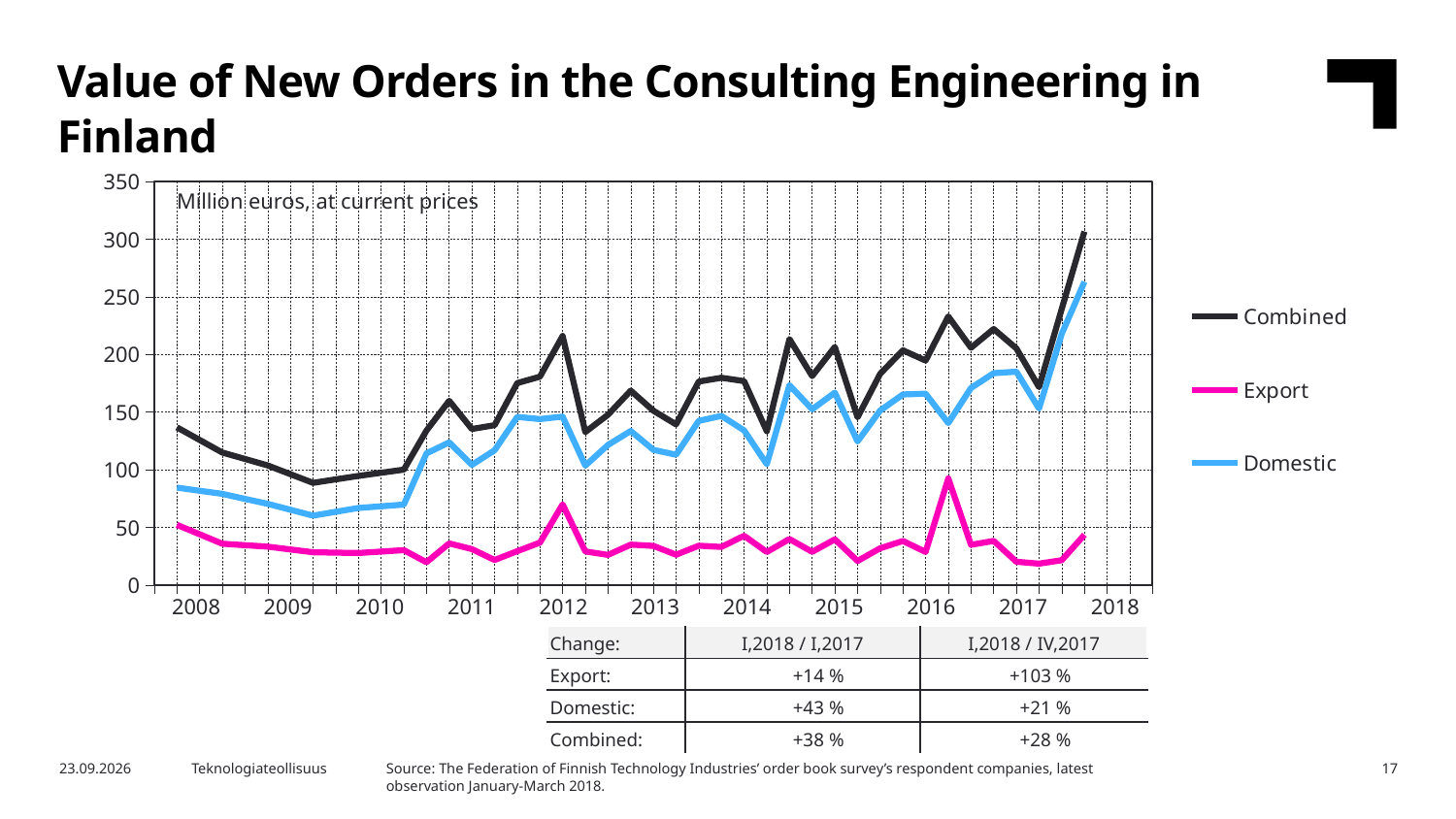
What kind of chart is shown on the slide? Line chart Is the value of the Export series at the final point in 2018 greater or less than 50? less Does the Combined series rise or fall between 2017 and 2018? rise What unit is stated inside the chart area? Million euros, at current prices Is the value of the Combined series at the final point in 2018 greater or less than 250? greater Which series has the highest values throughout the chart? Combined Which series has the lowest values throughout the chart? Export Is the peak of the Export series in 2016 greater or less than 100? less At the final point in 2018, which is larger, the Domestic value or the Export value? Domestic How many series does the legend list? 3 Which series is drawn in pink? Export